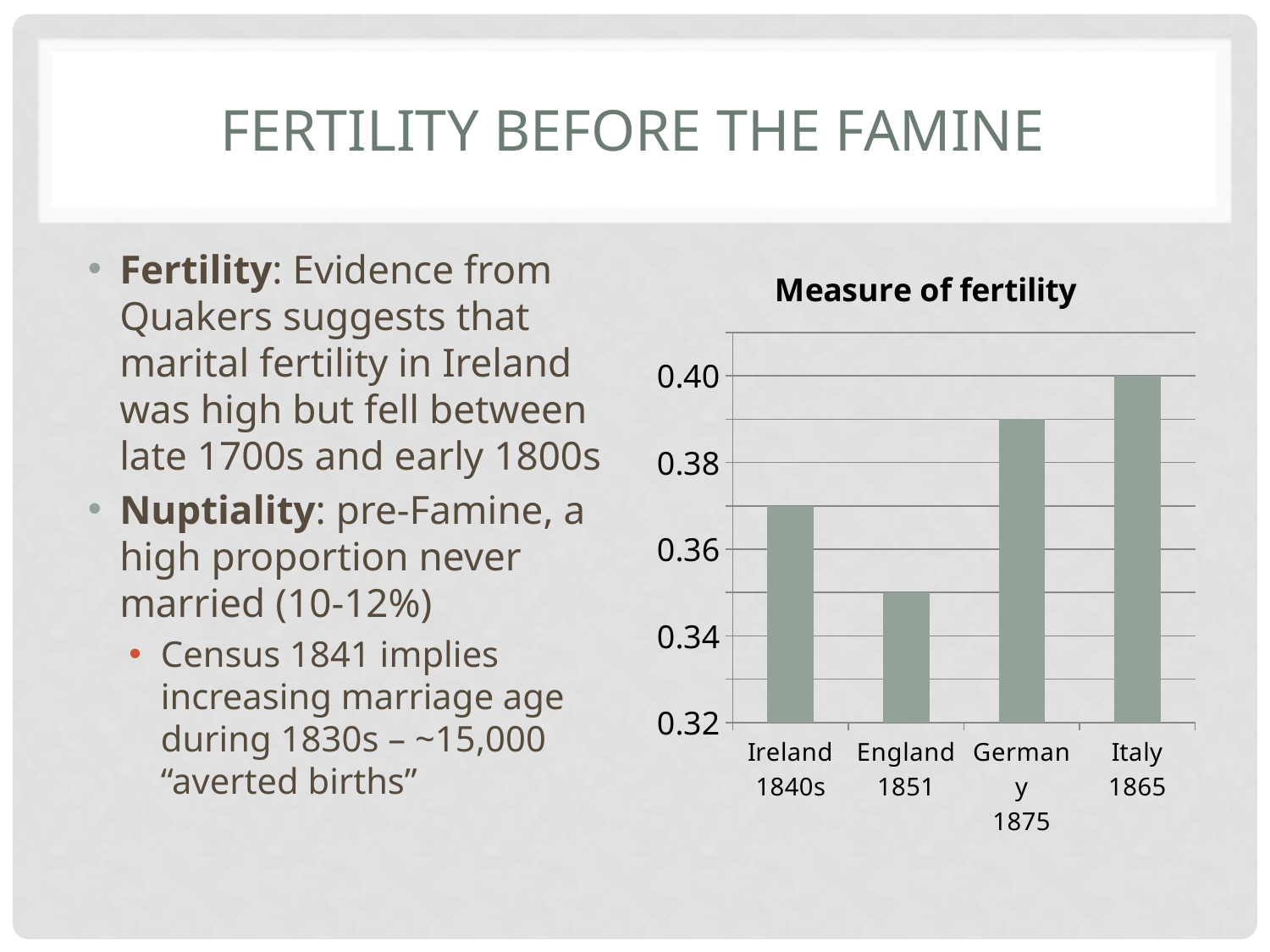
Is the value for Germany 1875 greater or less than 0.38? greater What is the title of the chart? Measure of fertility What is the value for Italy 1865? 0.40 What is the lowest value shown on the vertical axis of the chart? 0.32 How many categories are shown in the chart? 4 Which category has the highest value in the chart? Italy 1865 Which is larger, the value for Germany 1875 or the value for Ireland 1840s? Germany 1875 Which is larger, the value for Ireland 1840s or the value for England 1851? Ireland 1840s Is the value for England 1851 greater or less than 0.36? less Is the value for Ireland 1840s greater or less than 0.36? greater Which category has the lowest value in the chart? England 1851 What type of chart is shown on the slide? bar chart